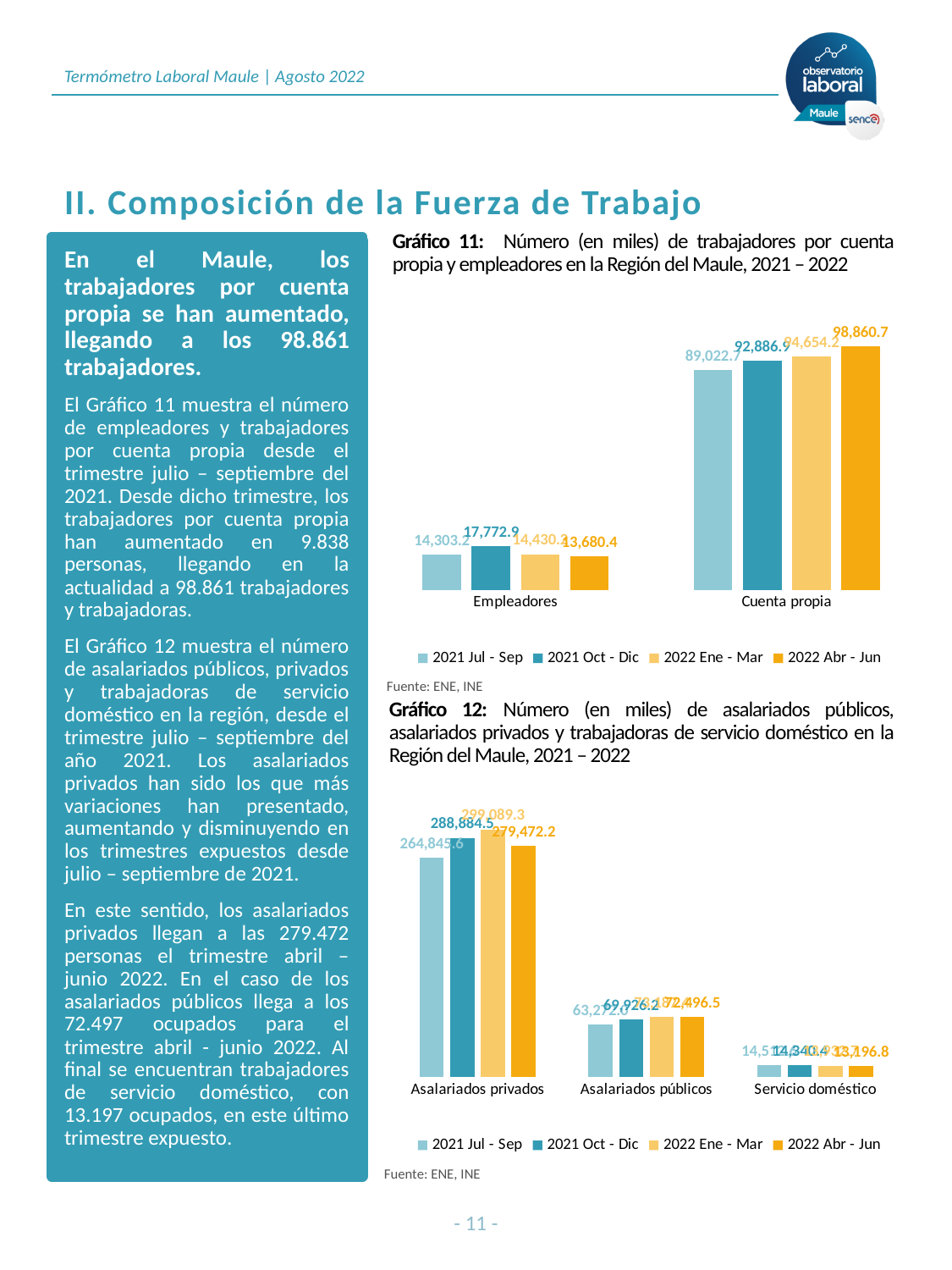
How many categories are shown on the x axis of Gráfico 12? 3 In Gráfico 11, which quarter has the highest value for Cuenta propia? 2022 Abr - Jun In Gráfico 12, which is larger for Asalariados privados: 2021 Oct - Dic or 2022 Abr - Jun? 2021 Oct - Dic In Gráfico 11, what is the value for Cuenta propia in 2022 Abr - Jun? 98,860.7 What kind of chart is Gráfico 12? bar chart How many series does the legend of Gráfico 11 list? 4 In Gráfico 12, which quarter has the highest value for Asalariados privados? 2022 Ene - Mar In Gráfico 11, what is the value for Empleadores in 2021 Oct - Dic? 17,772.9 In Gráfico 11, what is the difference between the Cuenta propia values for 2022 Abr - Jun and 2021 Jul - Sep? 9,838.0 In Gráfico 11, do the Cuenta propia values rise or fall from 2021 Jul - Sep to 2022 Abr - Jun? rise In Gráfico 12, what is the value for Asalariados públicos in 2022 Abr - Jun? 72,496.5 In Gráfico 12, what is the value for Asalariados privados in 2022 Ene - Mar? 299,089.3